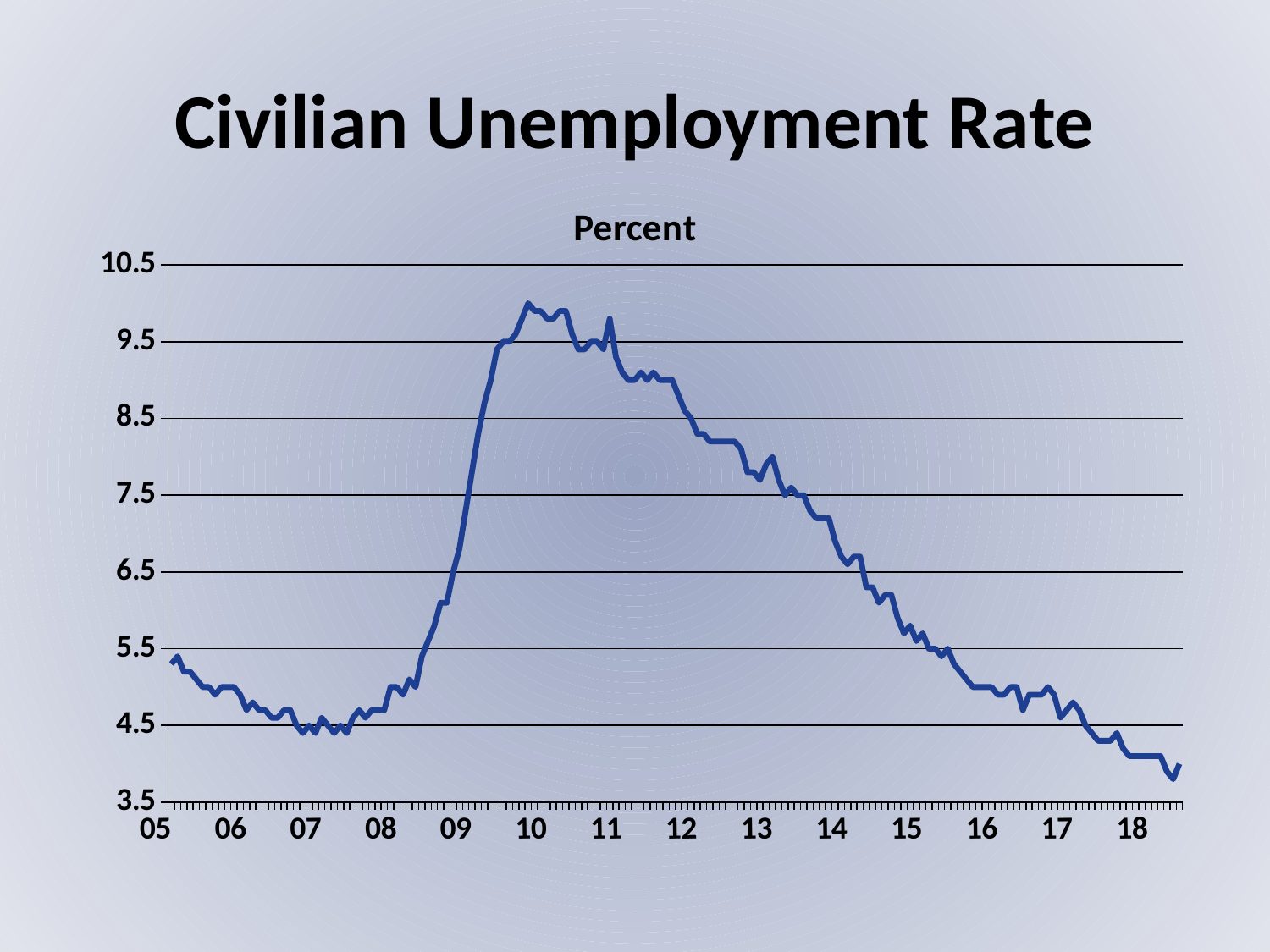
What kind of chart is shown on the slide? line chart How many year labels are shown along the x axis? 14 Is the unemployment rate at the start of 12 greater or less than 7.5? greater Is the peak unemployment rate around 10 greater or less than 9.5? greater Around which year label does the unemployment rate reach its highest point? 10 Around which year label does the unemployment rate reach its lowest point? 18 Does the unemployment rate rise or fall between 10 and 18? fall What unit label is shown above the y axis? Percent What is the title of the chart? Civilian Unemployment Rate Is the unemployment rate at the end of 18 greater or less than 4.5? less Which is higher, the unemployment rate at the start of 10 or at the end of 18? 10